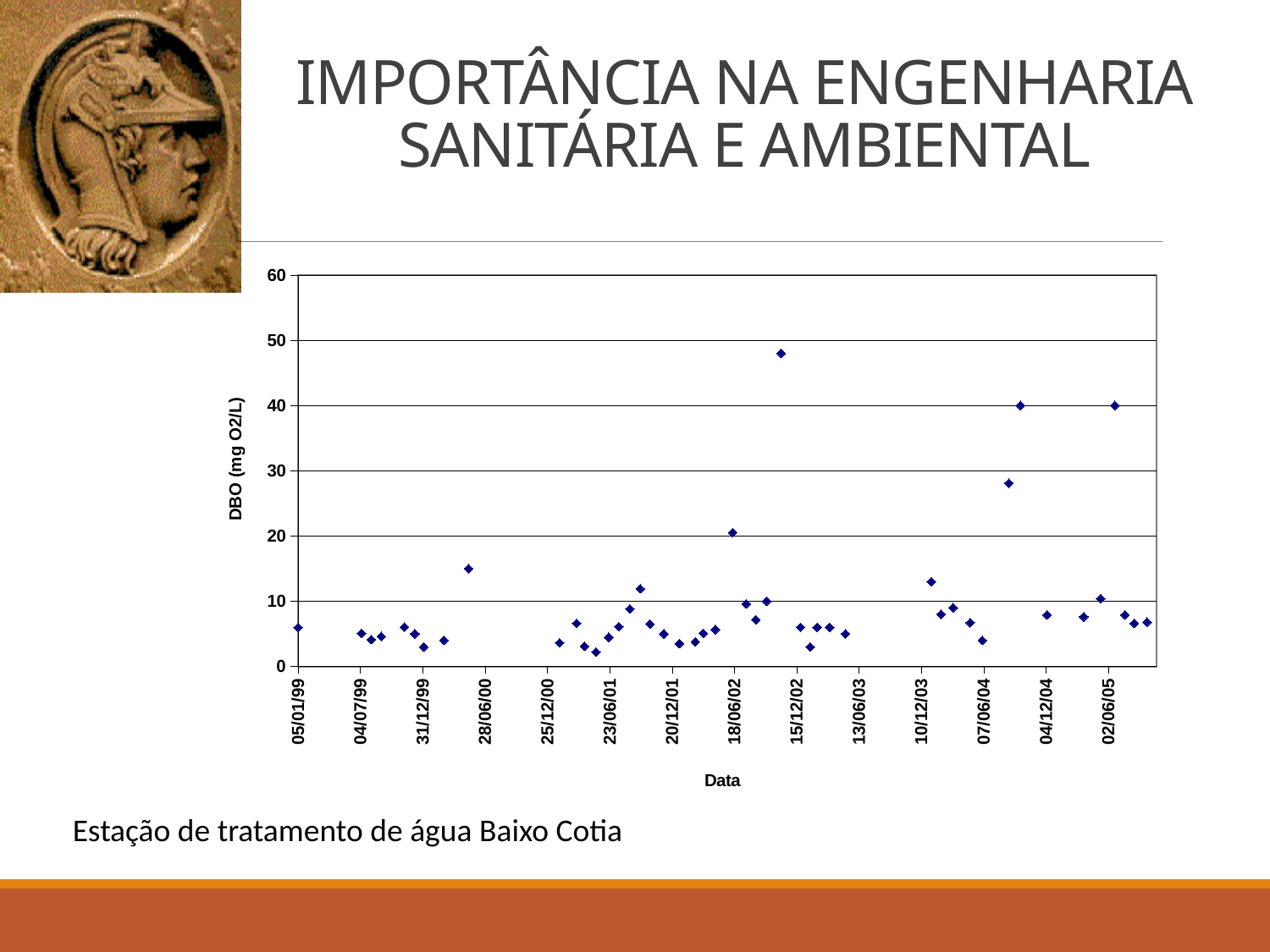
Is the DBO value plotted just before 28/06/00 greater or less than 10? greater Is the DBO value plotted at 05/01/99 greater or less than 10? less What is the label of the vertical axis of the chart? DBO (mg O2/L) What is the maximum value shown on the vertical axis? 60 Is the highest plotted DBO value greater or less than 40? greater What kind of chart is shown on the slide? scatter chart Near which date label does the highest DBO point appear? 15/12/02 What is the label of the horizontal axis of the chart? Data How many date labels are shown on the horizontal axis? 14